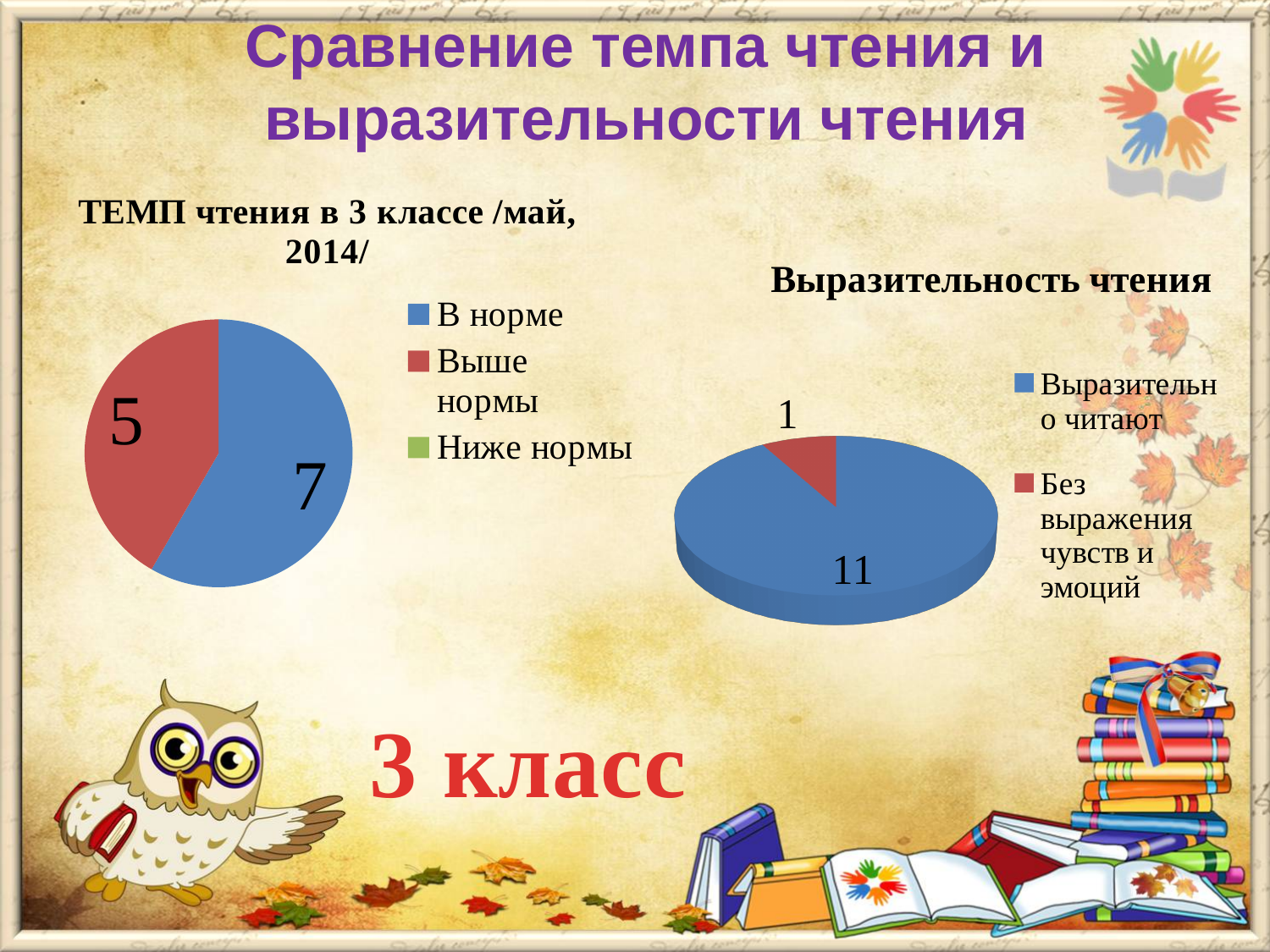
In the chart titled "Выразительность чтения", what is the value for "Без выражения чувств и эмоций"? 1 In the chart titled "Выразительность чтения", what is the value for "Выразительно читают"? 11 What type of chart is the chart titled "Выразительность чтения"? Pie chart How many entries does the legend of the chart titled "ТЕМП чтения в 3 классе /май, 2014/" list? 3 In the chart titled "ТЕМП чтения в 3 классе /май, 2014/", which category has the largest slice? В норме In the chart titled "ТЕМП чтения в 3 классе /май, 2014/", what is the difference between the values for "В норме" and "Выше нормы"? 2 In the chart titled "ТЕМП чтения в 3 классе /май, 2014/", what is the value for "Выше нормы"? 5 In the chart titled "Выразительность чтения", which is larger: "Выразительно читают" or "Без выражения чувств и эмоций"? Выразительно читают In the chart titled "Выразительность чтения", what is the difference between the values for "Выразительно читают" and "Без выражения чувств и эмоций"? 10 In the chart titled "ТЕМП чтения в 3 классе /май, 2014/", what is the value for "В норме"? 7 In the chart titled "ТЕМП чтения в 3 классе /май, 2014/", what colour is the "Выше нормы" slice? Red In the chart titled "Выразительность чтения", which category has the smallest slice? Без выражения чувств и эмоций